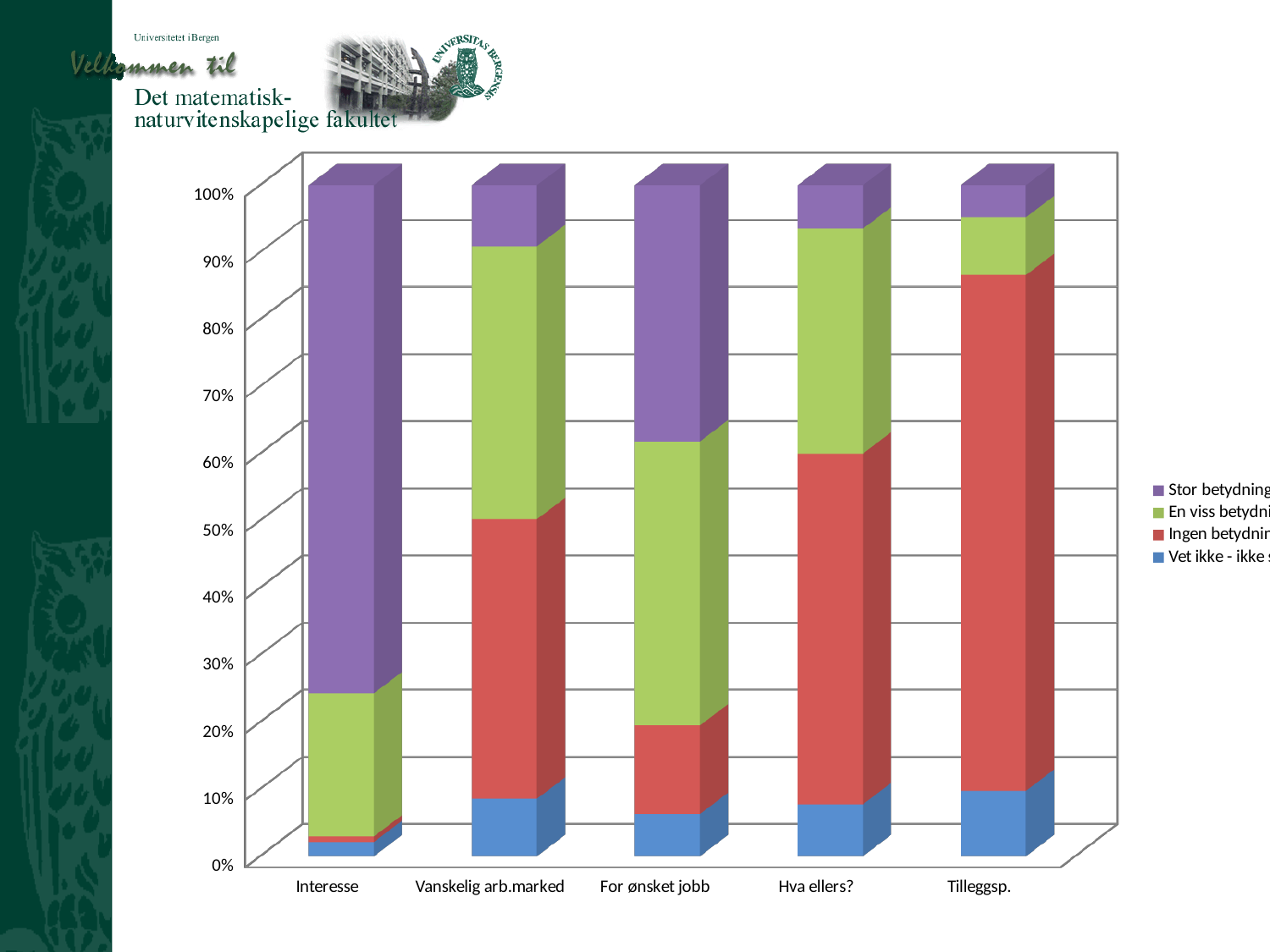
Is the 'Stor betydning' share for Interesse greater or less than 70%? greater How many series does the chart's legend list? 4 Which category has the largest 'Ingen betydning' (red) segment? Tilleggsp. Is the 'Stor betydning' segment larger for Interesse or for Vanskelig arb.marked? Interesse Which category has the smallest 'Ingen betydning' (red) segment? Interesse What kind of chart is shown on the slide? Stacked bar chart What colour represents the 'Stor betydning' series in the chart? Purple Which category has the largest 'Stor betydning' (purple) segment? Interesse Is the 'Ingen betydning' share for Tilleggsp. greater or less than 70%? greater Is the 'Ingen betydning' share for Hva ellers? greater or less than 40%? greater Is the 'Ingen betydning' segment larger for Tilleggsp. or for For ønsket jobb? Tilleggsp. How many categories are shown along the x axis of the chart? 5